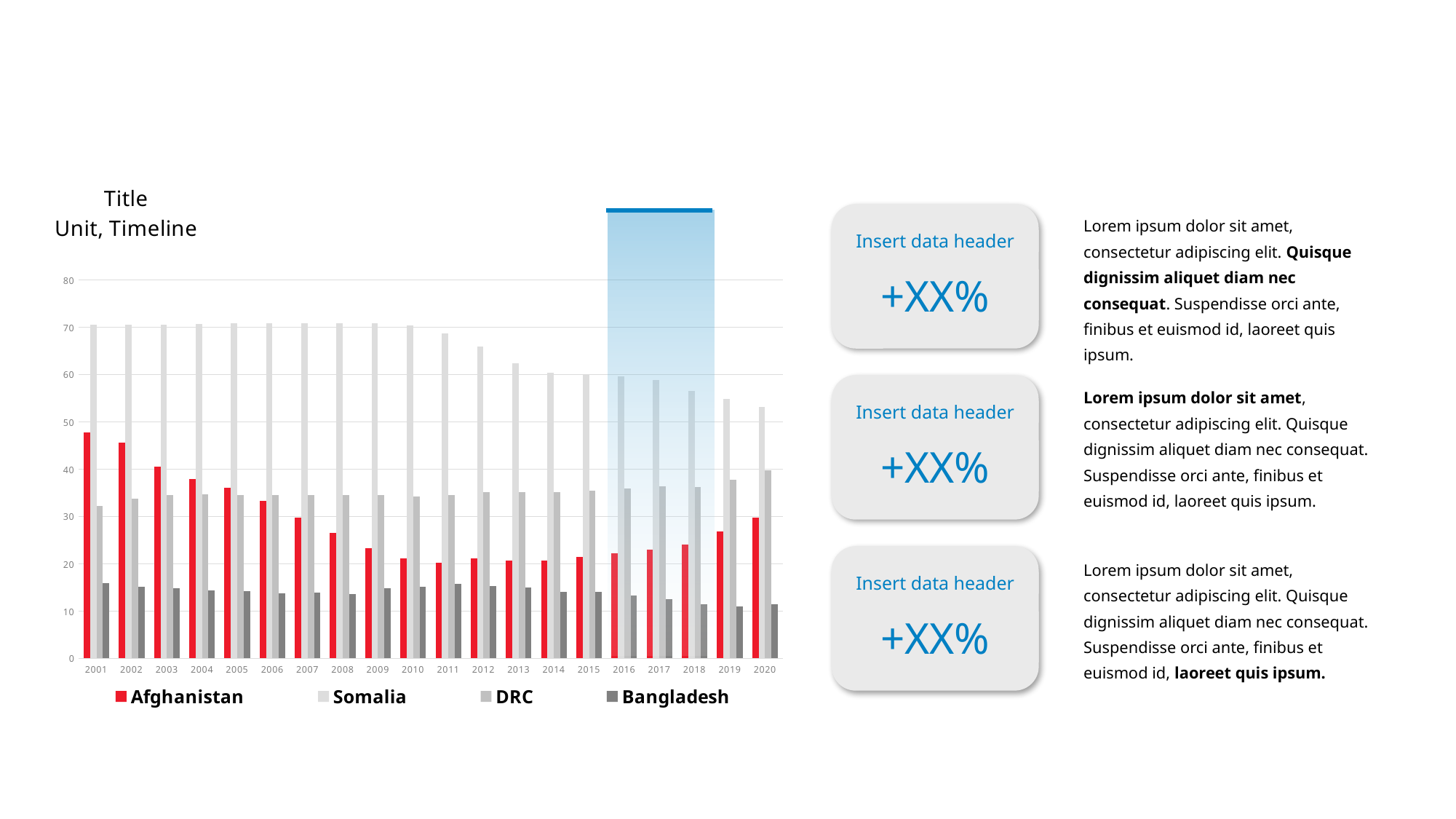
Which series is shown in red in the chart? Afghanistan Do the values for Somalia generally rise or fall from 2001 to 2020? fall What kind of chart is shown on the slide? bar chart How many series does the chart's legend list? 4 Is the value for Somalia in 2001 greater or less than 60? greater In which year is the value for Afghanistan highest? 2001 How many years are shown along the x axis of the chart? 20 Is the value for Afghanistan in 2015 greater or less than 30? less Is the value for Afghanistan in 2001 greater or less than 40? greater In 2001, which is larger: the value for Somalia or the value for Afghanistan? Somalia